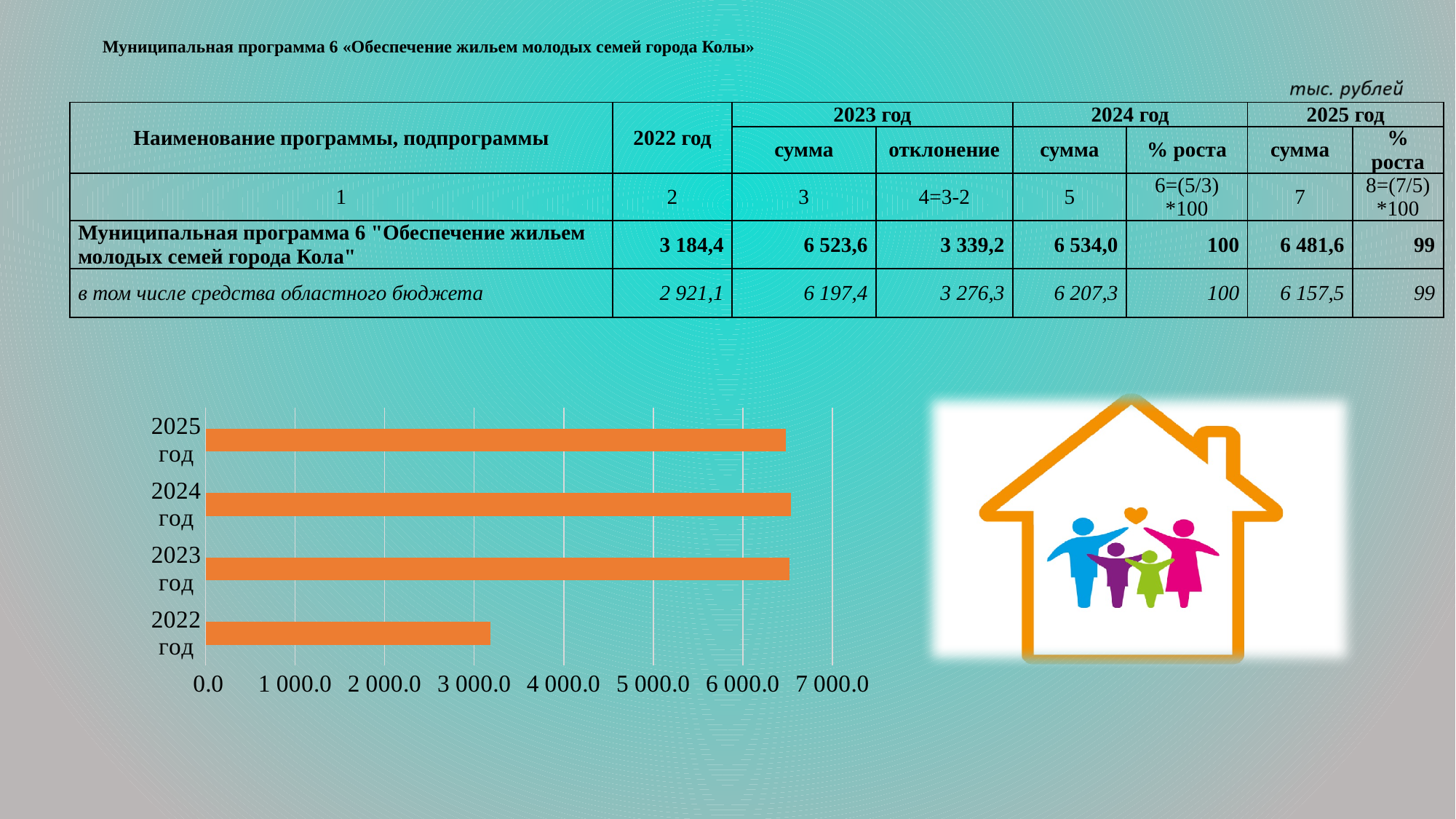
Which year has the lowest value in the bar chart? 2022 год How many years (categories) are plotted in the bar chart? 4 Is the value for 2025 год in the bar chart greater or less than 5 000.0? greater What colour are the bars in the chart? orange What kind of chart is shown on the slide? bar chart Is the value for 2024 год in the bar chart greater or less than 7 000.0? less Does the value rise or fall from 2022 год to 2023 год in the bar chart? rise Is the value for 2023 год in the bar chart greater or less than 6 000.0? greater Which is larger in the bar chart, the value for 2025 год or the value for 2022 год? 2025 год What is the highest tick label shown on the horizontal axis of the bar chart? 7 000.0 Which is larger in the bar chart, the value for 2022 год or the value for 2023 год? 2023 год